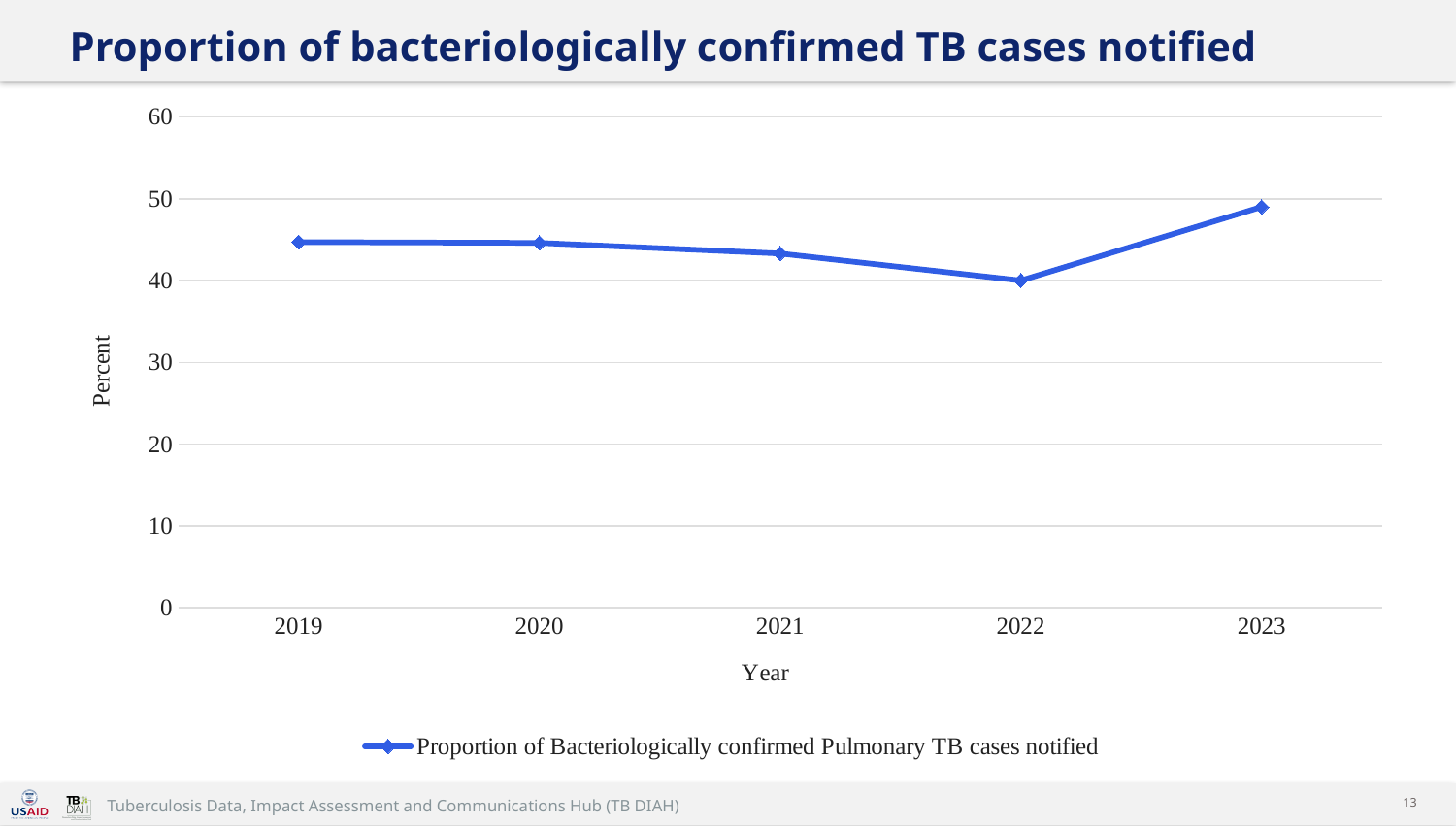
Which year has the highest proportion of bacteriologically confirmed TB cases notified? 2023 Is the value for 2021 greater or less than 40? greater Is the value for 2023 greater or less than 40? greater What kind of chart is shown on the slide? line chart How many years are plotted on the x axis? 5 What is the title of the chart? Proportion of bacteriologically confirmed TB cases notified Which is larger, the value for 2022 or the value for 2023? 2023 What is the label on the y axis? Percent Which year has the lowest proportion of bacteriologically confirmed TB cases notified? 2022 How many series does the legend list? 1 Do the values rise or fall from 2019 to 2022? fall Is the value for 2019 greater or less than 50? less